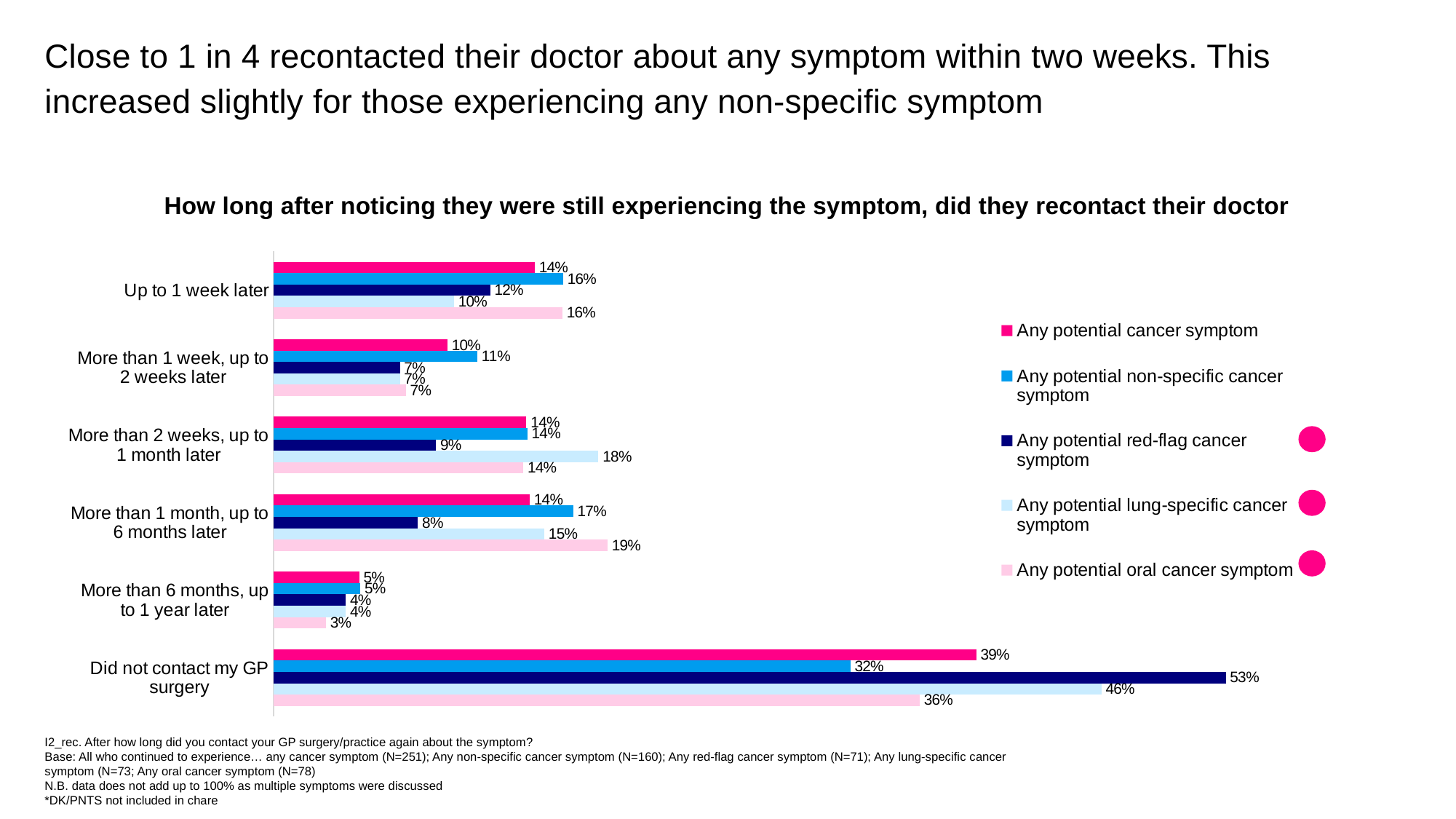
What is the difference between the 'Any potential red-flag cancer symptom' and 'Any potential non-specific cancer symptom' values in the 'Did not contact my GP surgery' category? 21% What is the value for 'Any potential cancer symptom' in the 'More than 1 week, up to 2 weeks later' category? 10% What is the value for 'Any potential red-flag cancer symptom' in the 'Did not contact my GP surgery' category? 53% What kind of chart is shown on the slide? Bar chart Which series has the lowest value in the 'More than 6 months, up to 1 year later' category? Any potential oral cancer symptom How many series does the legend list? 5 Which series has the highest value in the 'Did not contact my GP surgery' category? Any potential red-flag cancer symptom How many time-period categories are shown on the chart? 6 What is the value for 'Any potential oral cancer symptom' in the 'More than 1 month, up to 6 months later' category? 19% What is the value for 'Any potential lung-specific cancer symptom' in the 'Up to 1 week later' category? 10% What is the title of the chart? How long after noticing they were still experiencing the symptom, did they recontact their doctor In the 'More than 2 weeks, up to 1 month later' category, which is larger: 'Any potential lung-specific cancer symptom' or 'Any potential red-flag cancer symptom'? Any potential lung-specific cancer symptom